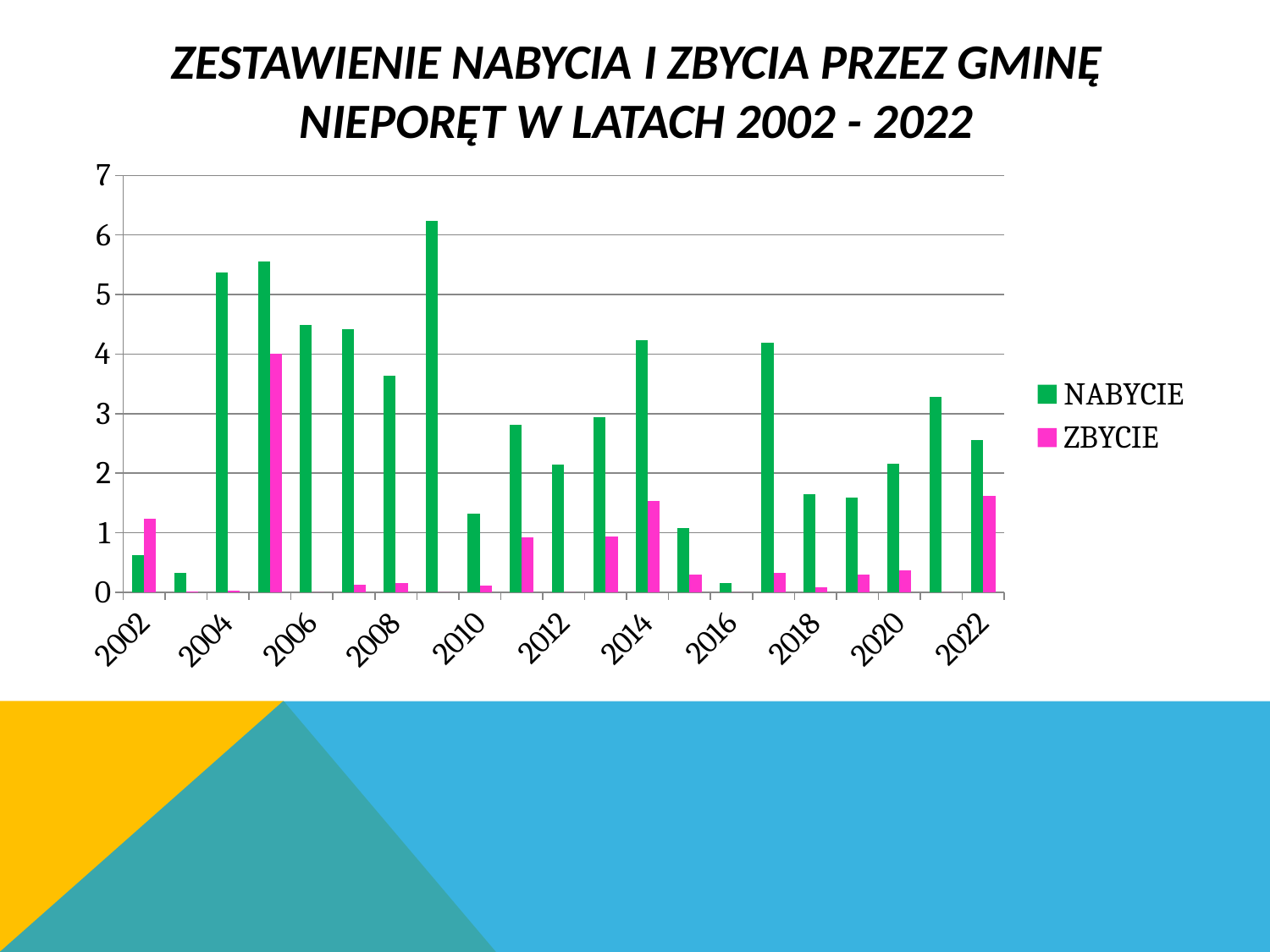
Is the NABYCIE value for 2008 greater or less than 4? less Which is larger in 2022, NABYCIE or ZBYCIE? NABYCIE Does the NABYCIE value rise or fall from 2004 to 2008? fall Which is larger in 2002, NABYCIE or ZBYCIE? ZBYCIE Is the NABYCIE value for 2016 greater or less than 1? less What kind of chart is shown on the slide? bar chart How many years are plotted on the x axis? 21 How many series does the legend list? 2 Is the ZBYCIE value for 2002 greater or less than 1? greater Which year has the lowest NABYCIE value? 2016 Which colour represents the ZBYCIE series? pink